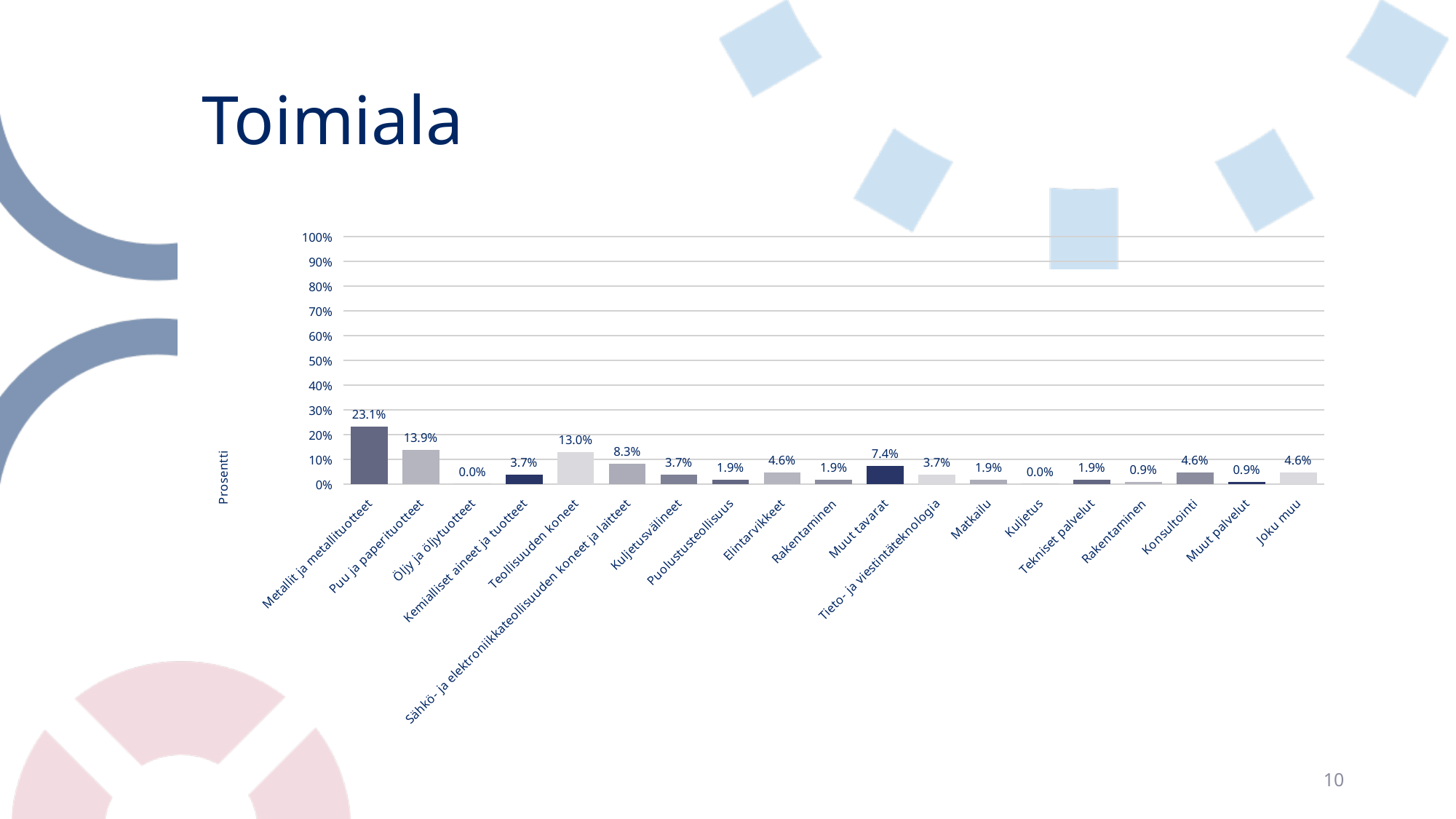
What kind of chart is shown on the slide? bar chart Which categories have the lowest value? Öljy ja öljytuotteet and Kuljetus What is the label of the vertical axis? Prosentti How many categories are shown on the x axis? 19 What is the value for Teollisuuden koneet? 13.0% What is the value for Muut tavarat? 7.4% What is the value for Metallit ja metallituotteet? 23.1% Which is larger, Puu ja paperituotteet or Teollisuuden koneet? Puu ja paperituotteet Is the value for Metallit ja metallituotteet greater or less than 20%? greater Which category has the highest value? Metallit ja metallituotteet What is the difference between Metallit ja metallituotteet and Puu ja paperituotteet? 9.2% What is the value for Sähkö- ja elektroniikkateollisuuden koneet ja laitteet? 8.3%